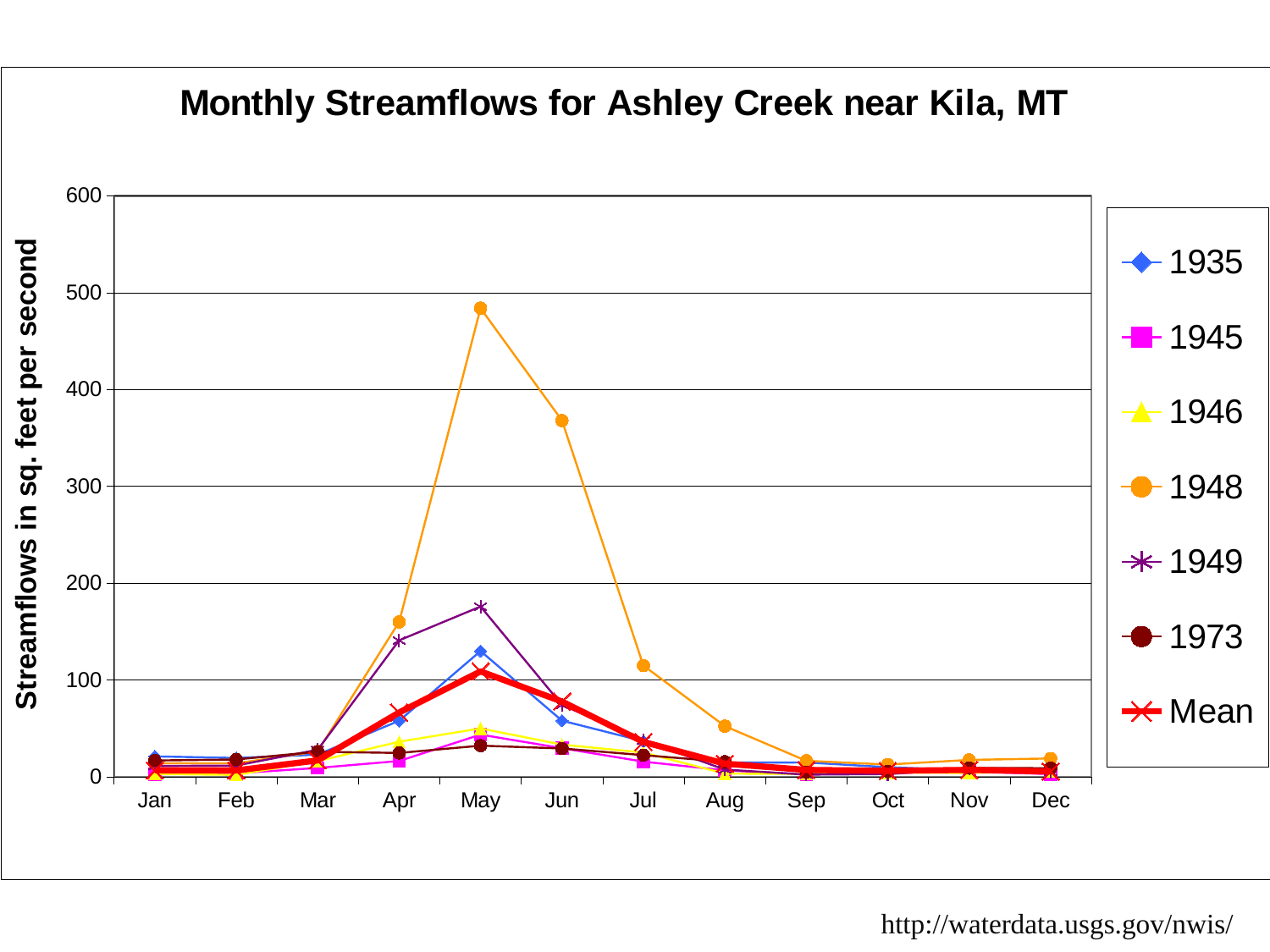
How many months are plotted along the x axis? 12 What type of chart is shown on the slide? line chart How many series does the legend list? 7 What is the title of the chart? Monthly Streamflows for Ashley Creek near Kila, MT Is the value for 1948 in May greater or less than 400? greater Do the values for the 1948 series rise or fall from May to September? fall Which is larger in May, the value for 1948 or the value for 1949? 1948 Which is larger in May, the value for 1935 or the value for 1945? 1935 In which month does the 1948 series reach its highest value? May Is the value for 1948 in June greater or less than 300? greater Which series has the highest value in May? 1948 Is the value for 1949 in May greater or less than 150? greater